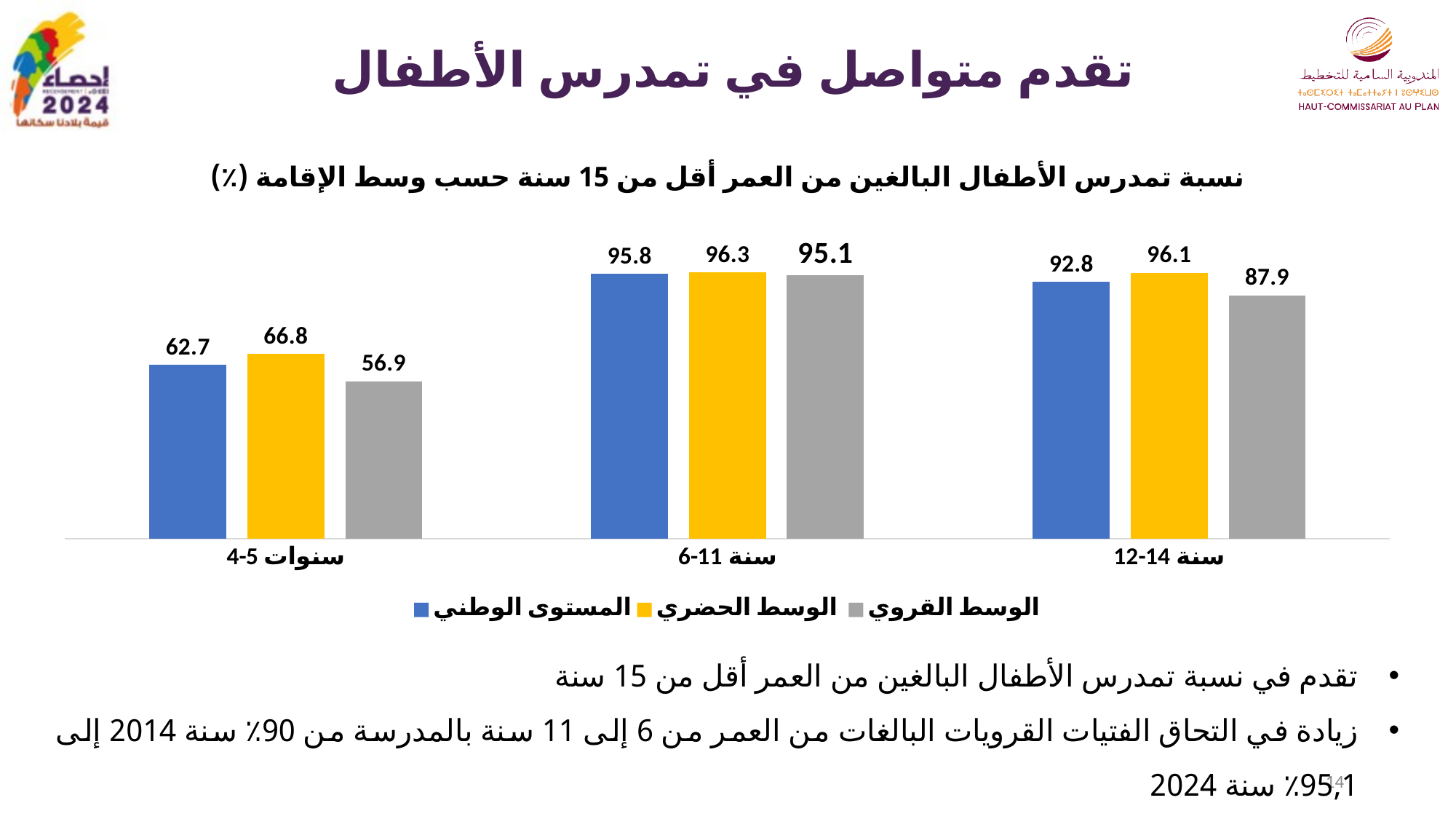
What is the schooling rate for the urban area (الوسط الحضري) in the 6-11 سنة age group? 96.3 What is the schooling rate for the national level (المستوى الوطني) in the 4-5 سنوات age group? 62.7 How many series does the chart legend list? 3 What is the difference between the urban (الوسط الحضري) and rural (الوسط القروي) schooling rates in the 12-14 سنة age group? 8.2 Which colour represents the rural area (الوسط القروي) in the chart? gray What is the schooling rate for the rural area (الوسط القروي) in the 12-14 سنة age group? 87.9 Which age group has the lowest schooling rate for the national level (المستوى الوطني)? 4-5 سنوات In the 4-5 سنوات age group, which is larger: the urban (الوسط الحضري) rate or the rural (الوسط القروي) rate? الوسط الحضري Within the 12-14 سنة age group, which series has the highest schooling rate? الوسط الحضري What type of chart is shown on the slide? bar chart What is the schooling rate for the rural area (الوسط القروي) in the 4-5 سنوات age group? 56.9 How many age-group categories are shown on the x axis of the chart? 3